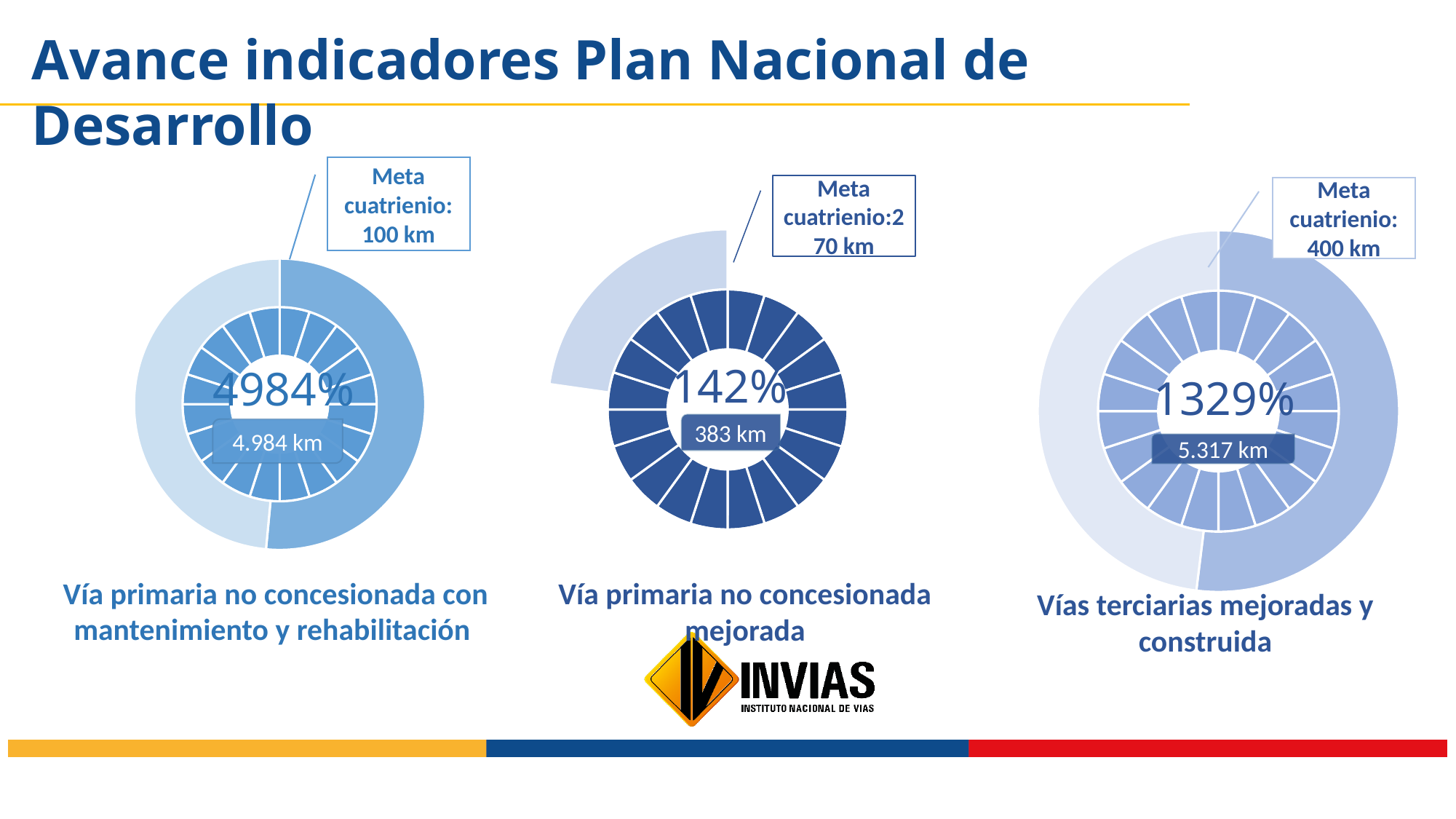
On the middle chart, what is the 'Meta cuatrienio' value? 270 km On the right chart ('Vías terciarias mejoradas y construida'), how many km are shown in the centre label? 5.317 km On the middle chart ('Vía primaria no concesionada mejorada'), by how many km does the achieved value exceed the 'Meta cuatrienio'? 113 km On the left chart, what is the 'Meta cuatrienio' value? 100 km Which of the three charts shows the lowest percentage? Vía primaria no concesionada mejorada On the chart titled 'Vía primaria no concesionada con mantenimiento y rehabilitación', what percentage is shown in the centre? 4984% On the chart titled 'Vía primaria no concesionada mejorada', what percentage is shown in the centre? 142% On the chart titled 'Vías terciarias mejoradas y construida', what percentage is shown in the centre? 1329% On the middle chart ('Vía primaria no concesionada mejorada'), how many km are shown in the centre label? 383 km On the right chart, what is the 'Meta cuatrienio' value? 400 km Which of the three charts shows the highest percentage? Vía primaria no concesionada con mantenimiento y rehabilitación On the left chart ('Vía primaria no concesionada con mantenimiento y rehabilitación'), how many km are shown in the centre label? 4.984 km